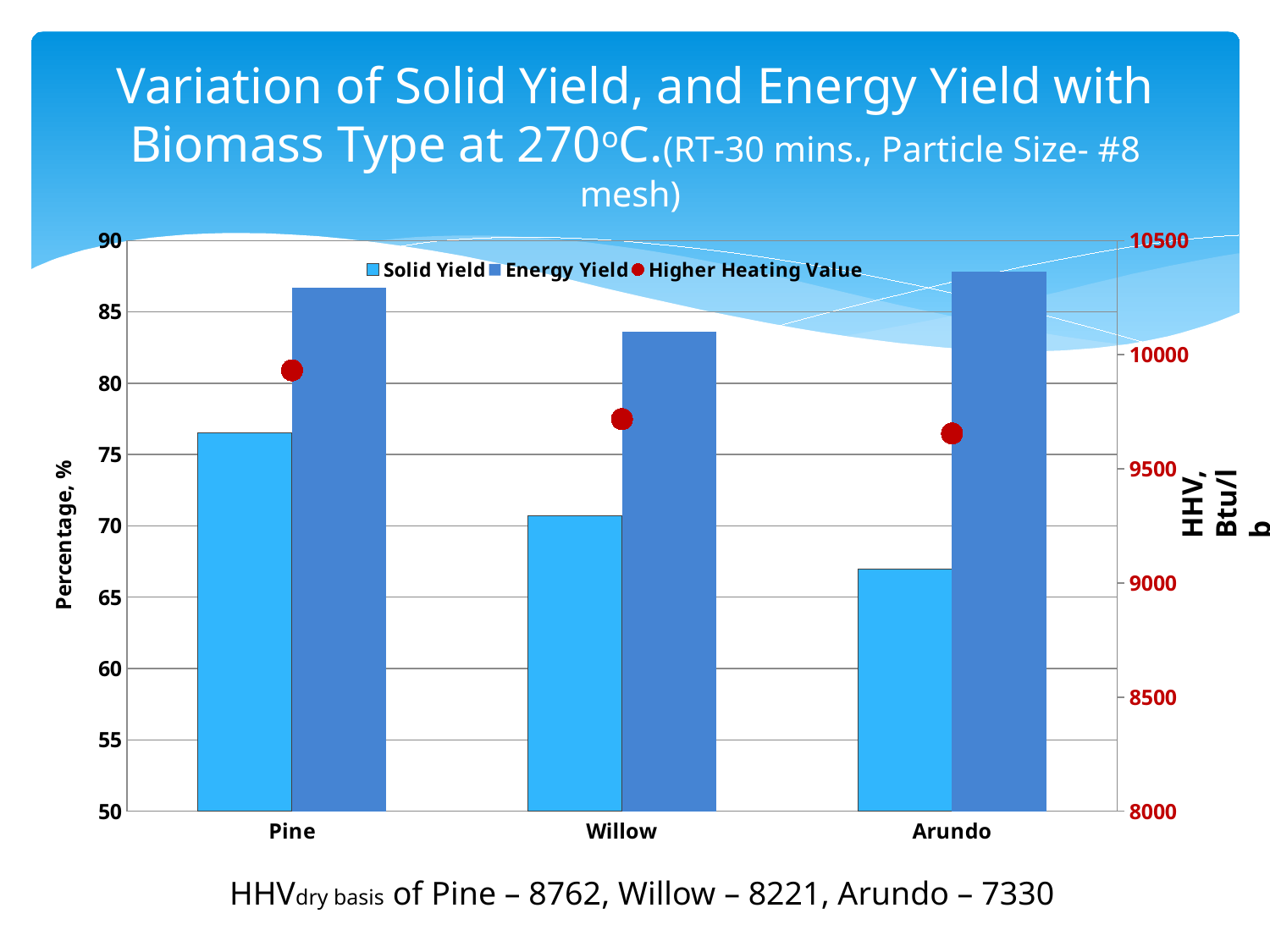
How many biomass types are shown on the x axis? 3 Which biomass type has the highest Higher Heating Value? Pine Is the Solid Yield for Pine greater or less than 75? greater Which biomass type has the highest Solid Yield? Pine Which biomass type has the lowest Energy Yield? Willow Does the Solid Yield rise or fall from Pine to Arundo? fall Is the Solid Yield for Arundo greater or less than 70? less Is the Higher Heating Value for Pine greater or less than 10000? less What kind of chart is shown on the slide? bar chart (with a point series for Higher Heating Value) Which biomass type has the lowest Solid Yield? Arundo How many series does the legend list? 3